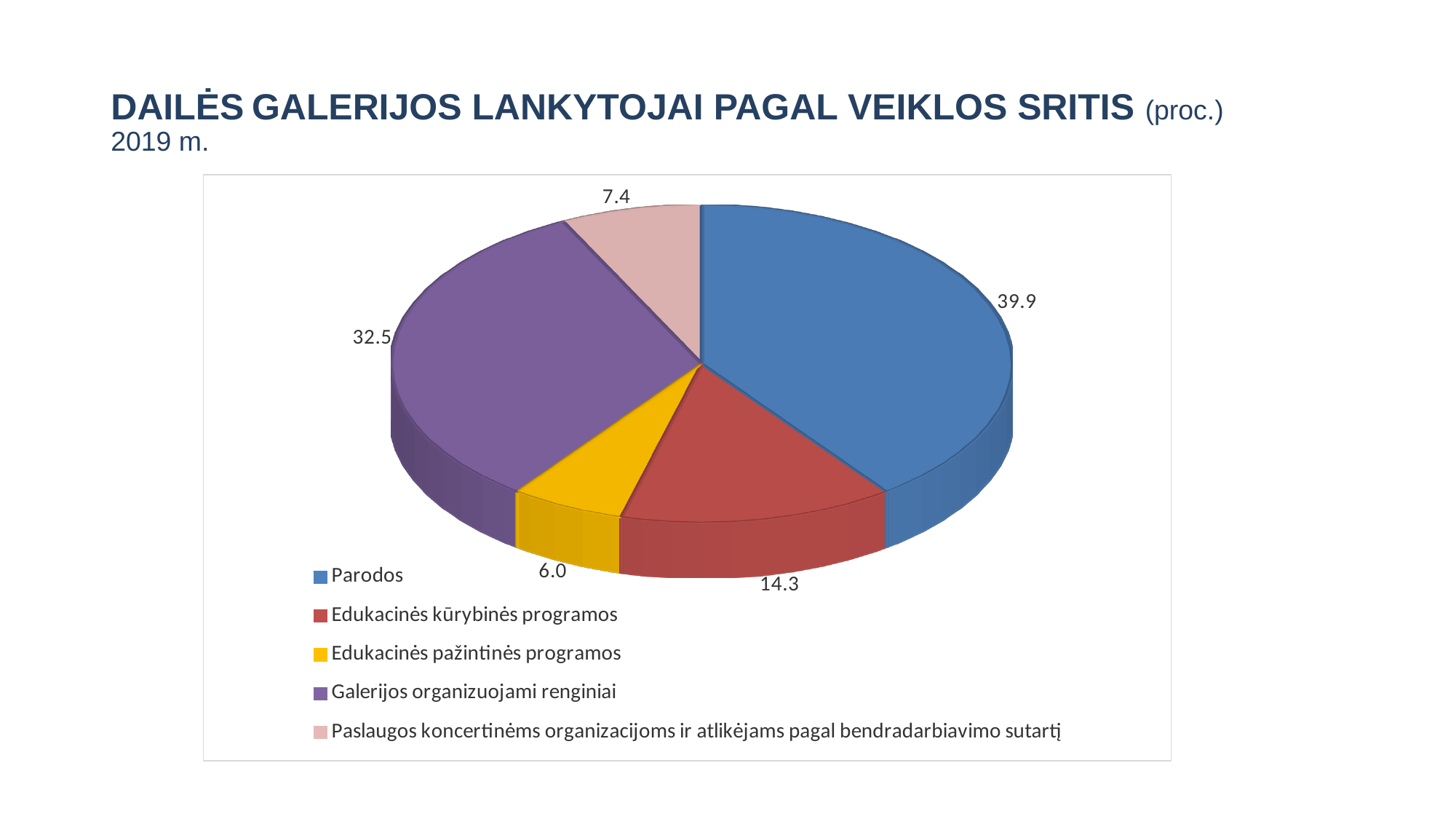
Which category has the smallest share? Edukacinės pažintinės programos What colour is the slice for Galerijos organizuojami renginiai? purple What is the difference between the values for Parodos and Galerijos organizuojami renginiai? 7.4 Which is larger, Edukacinės kūrybinės programos or Paslaugos koncertinėms organizacijoms ir atlikėjams pagal bendradarbiavimo sutartį? Edukacinės kūrybinės programos What is the value for Paslaugos koncertinėms organizacijoms ir atlikėjams pagal bendradarbiavimo sutartį? 7.4 Which category has the largest share? Parodos What is the value for Parodos? 39.9 What is the value for Edukacinės pažintinės programos? 6.0 What is the value for Galerijos organizuojami renginiai? 32.5 What kind of chart is shown on the slide? pie chart How many categories does the legend list? 5 What is the value for Edukacinės kūrybinės programos? 14.3